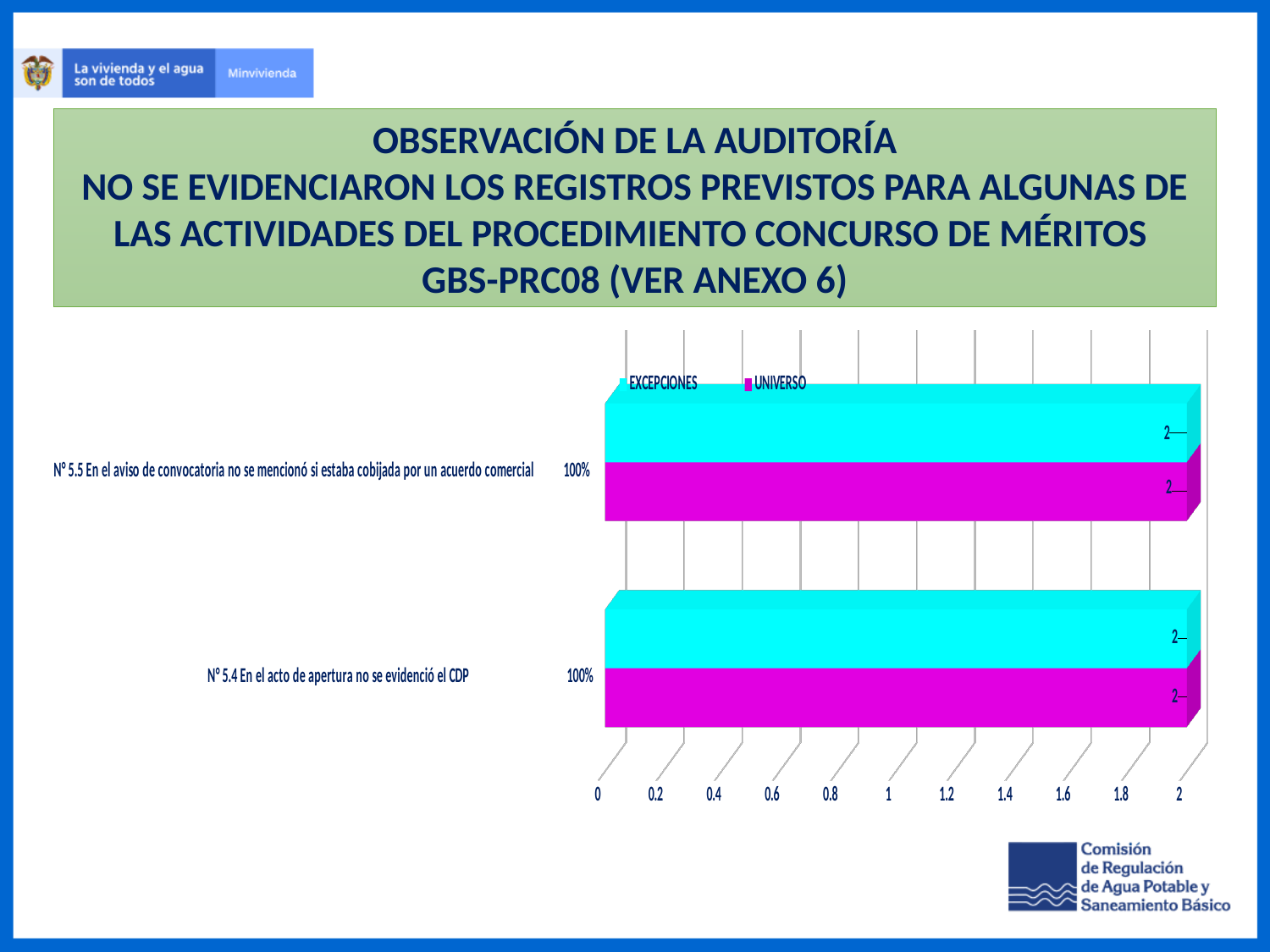
What is the UNIVERSO value for "Nº 5.5 En el aviso de convocatoria no se mencionó si estaba cobijada por un acuerdo comercial"? 2 What percentage is printed next to the category label "Nº 5.4 En el acto de apertura no se evidenció el CDP"? 100% How many series does the chart legend list? 2 What is the EXCEPCIONES value for "Nº 5.5 En el aviso de convocatoria no se mencionó si estaba cobijada por un acuerdo comercial"? 2 What is the difference between the EXCEPCIONES and UNIVERSO values for "Nº 5.4 En el acto de apertura no se evidenció el CDP"? 0 What is the highest value shown on the chart's horizontal axis? 2 What kind of chart is shown on the slide? bar chart Is the UNIVERSO value for "Nº 5.5 En el aviso de convocatoria no se mencionó si estaba cobijada por un acuerdo comercial" greater or less than 1? greater What is the UNIVERSO value for "Nº 5.4 En el acto de apertura no se evidenció el CDP"? 2 How many categories are plotted on the chart? 2 Which series is shown in magenta in the chart legend? UNIVERSO What is the EXCEPCIONES value for "Nº 5.4 En el acto de apertura no se evidenció el CDP"? 2